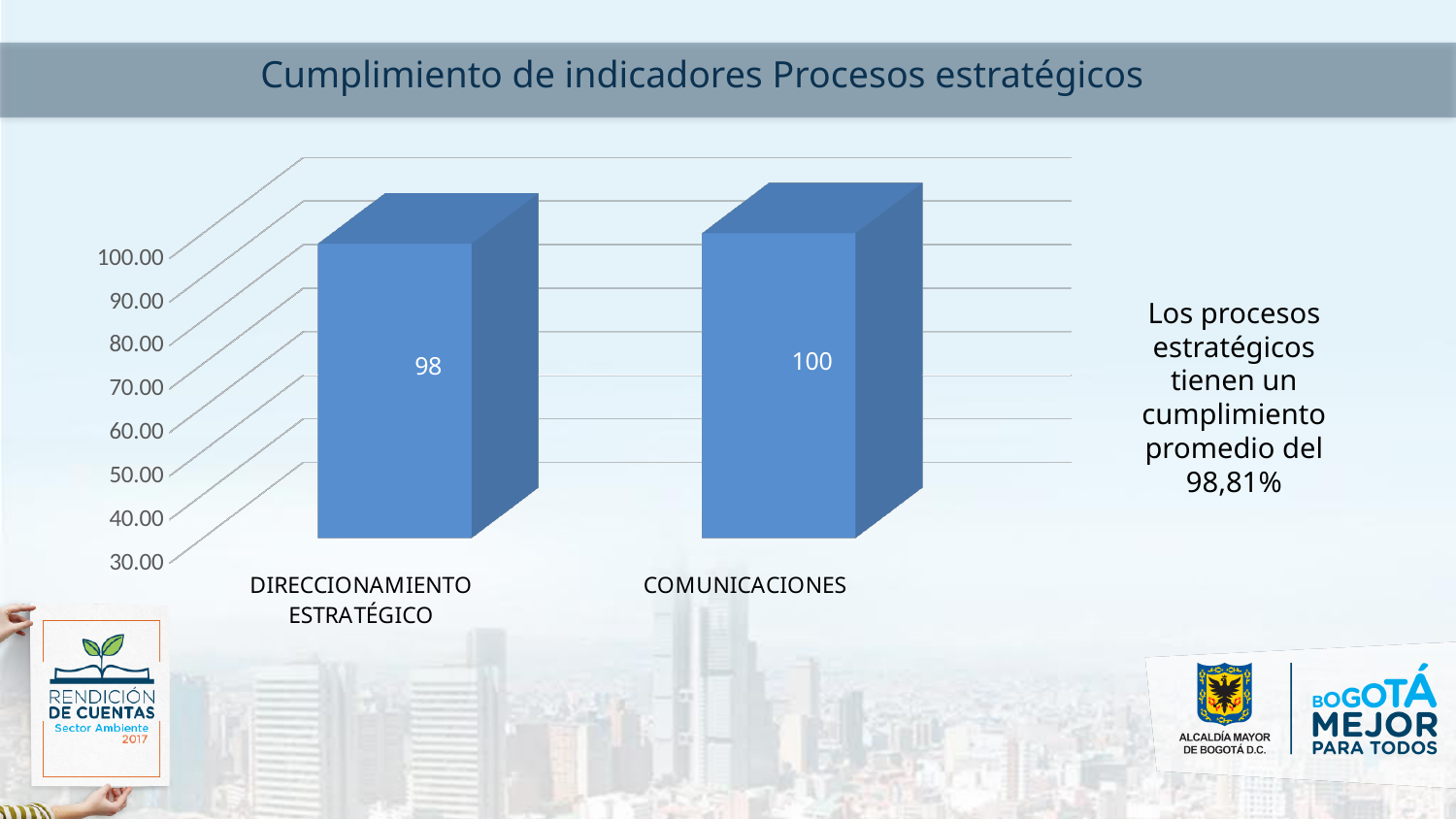
What is the title of the slide containing the chart? Cumplimiento de indicadores Procesos estratégicos What kind of chart is shown on the slide? bar chart What is the difference between the values for COMUNICACIONES and DIRECCIONAMIENTO ESTRATÉGICO? 2 Is the value for DIRECCIONAMIENTO ESTRATÉGICO greater or less than 90.00? greater What is the value for COMUNICACIONES? 100 Which category has the highest value? COMUNICACIONES Which is larger, the value for DIRECCIONAMIENTO ESTRATÉGICO or the value for COMUNICACIONES? COMUNICACIONES How many categories are shown in the chart? 2 What is the value for DIRECCIONAMIENTO ESTRATÉGICO? 98 What is the lowest value shown on the vertical axis? 30.00 Which category has the lowest value? DIRECCIONAMIENTO ESTRATÉGICO